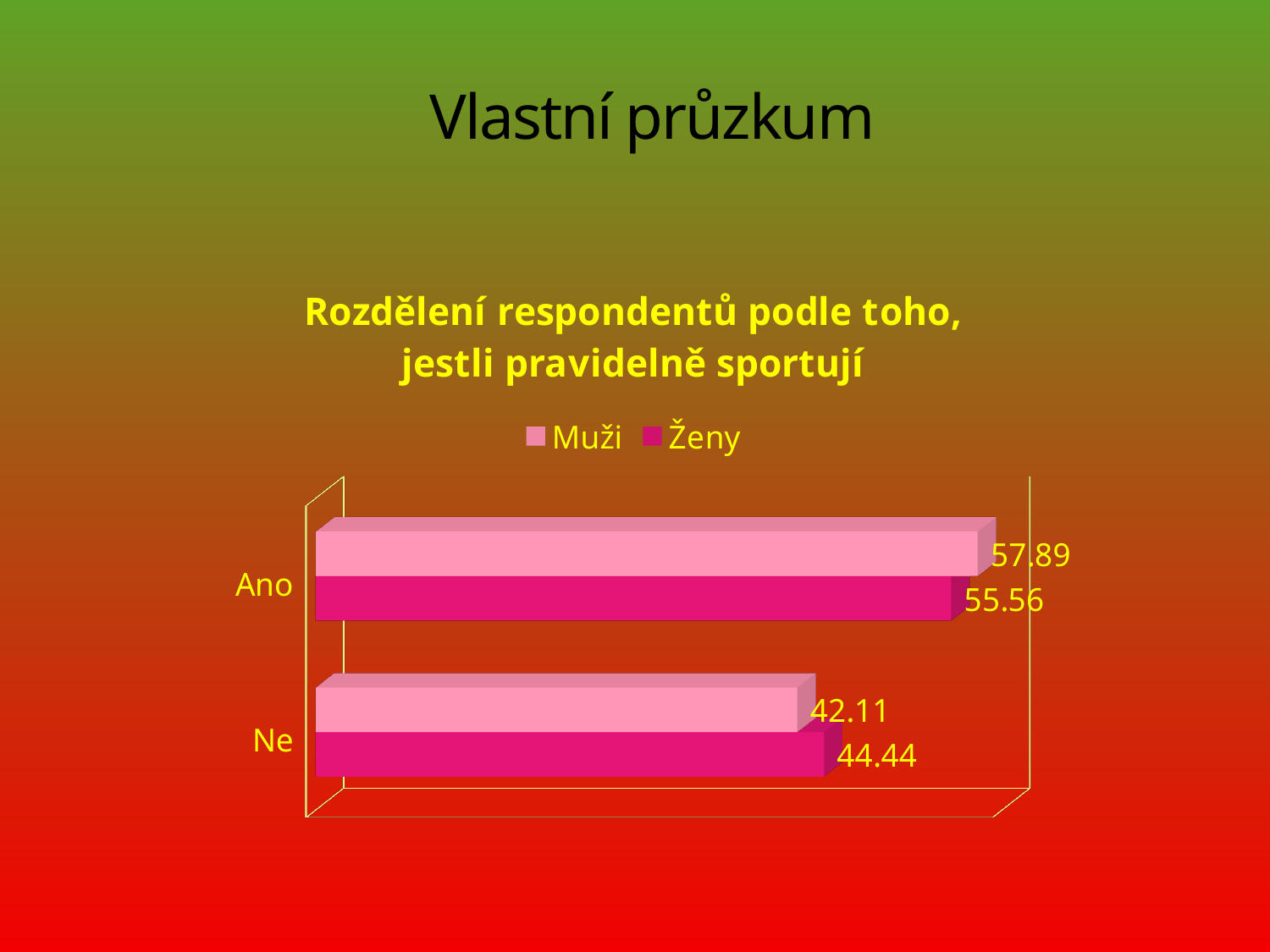
What is the difference between the Muži and Ženy values in the Ano category? 2.33 What is the value for Ženy in the Ne category? 44.44 In the Ne category, which is larger: Muži or Ženy? Ženy How many series does the legend list? 2 Which series has the lowest value in the chart? Muži What is the value for Muži in the Ano category? 57.89 What is the value for Muži in the Ne category? 42.11 What is the difference between the Muži values for Ano and Ne? 15.78 What is the value for Ženy in the Ano category? 55.56 What kind of chart is shown on the slide? Bar chart Which series has the highest value in the chart? Muži How many categories are shown on the chart? 2